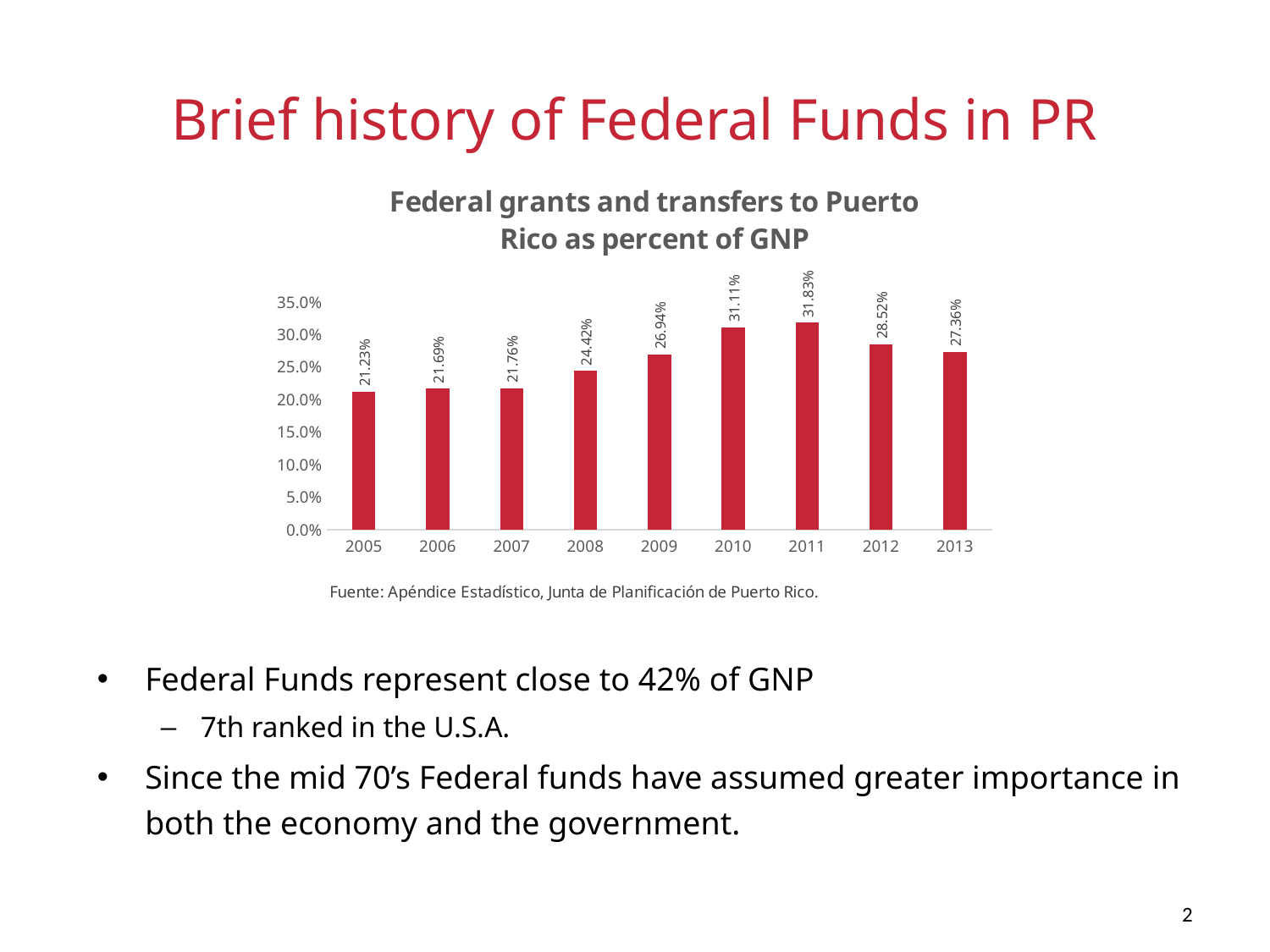
What is the value for 2005? 21.23% What is the title of the chart? Federal grants and transfers to Puerto Rico as percent of GNP How many years are shown on the x axis? 9 Is the value for 2010 greater or less than 30.0%? greater What is the difference between the values for 2011 and 2005? 10.60% What kind of chart is shown? bar chart Which is larger, the value for 2012 or the value for 2013? 2012 Do the values rise or fall from 2005 to 2011? rise Which year has the highest value? 2011 What is the value for 2013? 27.36% What is the value for 2011? 31.83% Which year has the lowest value? 2005